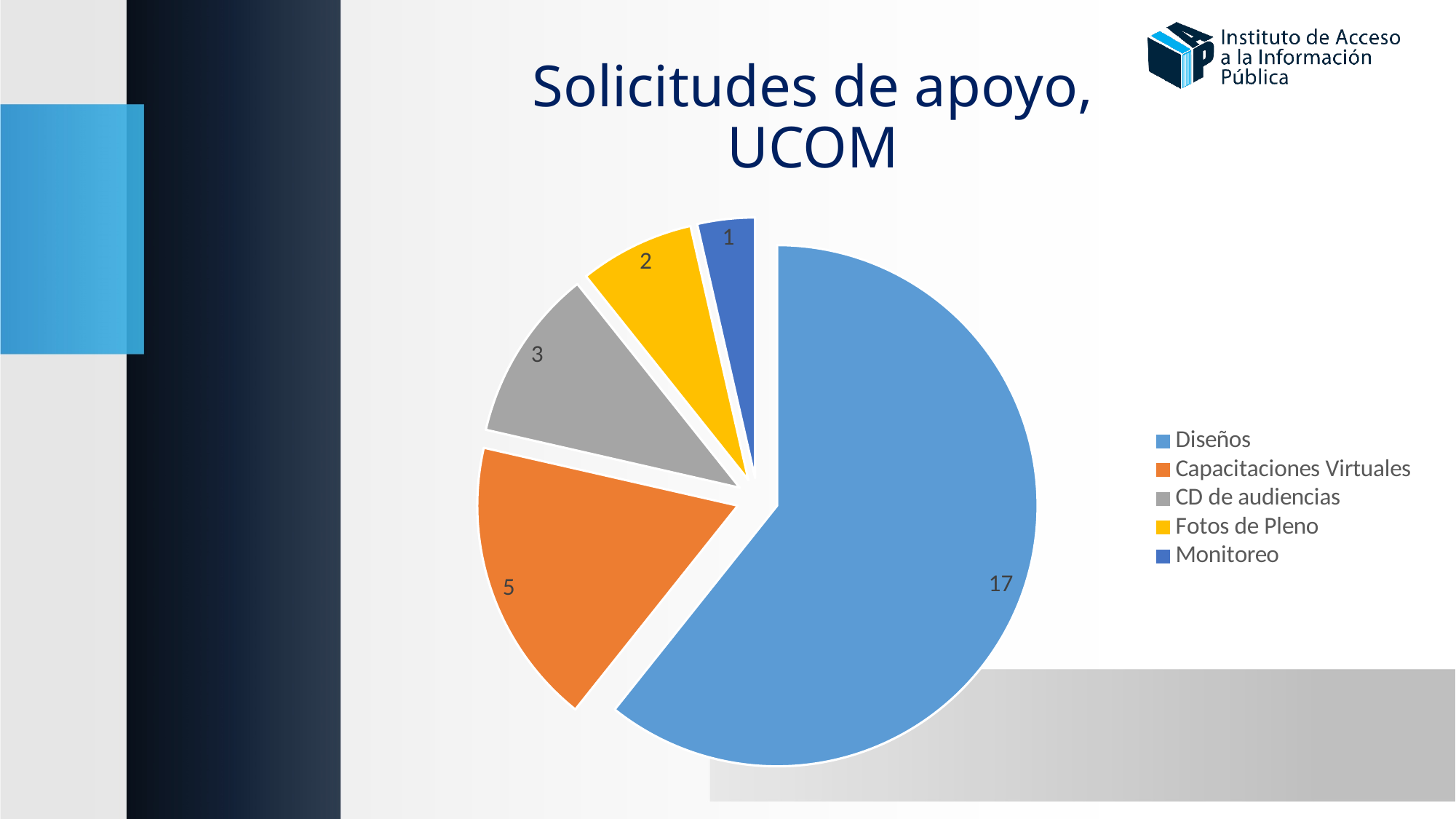
Which category has the largest slice? Diseños What is the value for CD de audiencias? 3 What is the value for Capacitaciones Virtuales? 5 Which is larger, CD de audiencias or Fotos de Pleno? CD de audiencias How many categories does the pie chart have? 5 What is the title of the chart? Solicitudes de apoyo, UCOM What is the value for Monitoreo? 1 Which category has the smallest slice? Monitoreo What is the value for Diseños? 17 What type of chart is shown on the slide? pie chart What is the value for Fotos de Pleno? 2 What is the difference between the values for Diseños and Capacitaciones Virtuales? 12